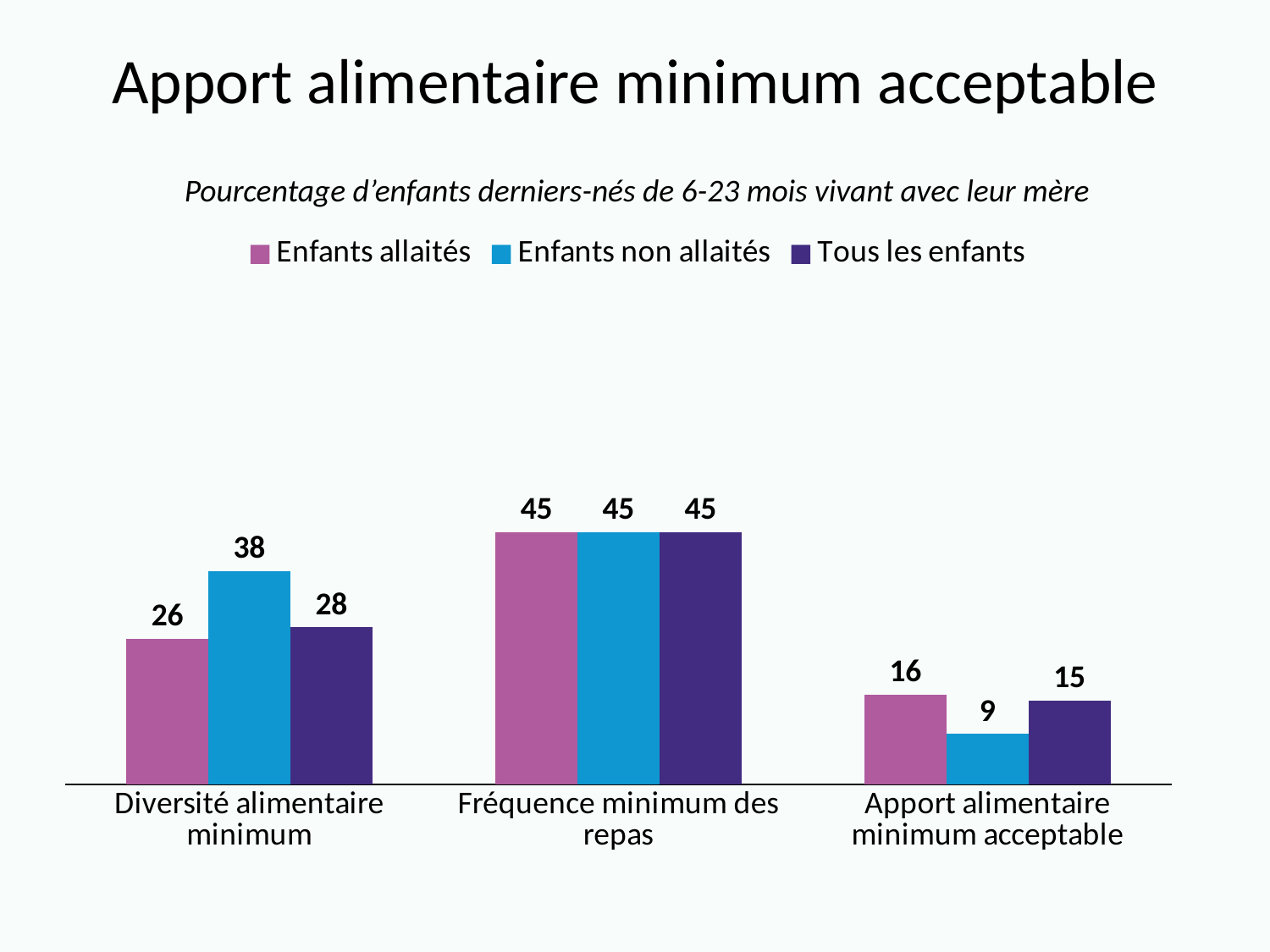
What is the difference between Enfants non allaités and Enfants allaités in the Diversité alimentaire minimum category? 12 Which category has the lowest value for Enfants non allaités? Apport alimentaire minimum acceptable How many series does the legend list? 3 What kind of chart is shown on the slide? bar chart What is the value for Tous les enfants in the Fréquence minimum des repas category? 45 Which category has the highest value for Tous les enfants? Fréquence minimum des repas Which series is shown in blue in the legend? Enfants non allaités What is the value for Enfants non allaités in the Diversité alimentaire minimum category? 38 In the Apport alimentaire minimum acceptable category, which is larger: Enfants allaités or Enfants non allaités? Enfants allaités What is the value for Enfants non allaités in the Apport alimentaire minimum acceptable category? 9 What is the value for Enfants allaités in the Apport alimentaire minimum acceptable category? 16 How many categories are shown on the x axis? 3